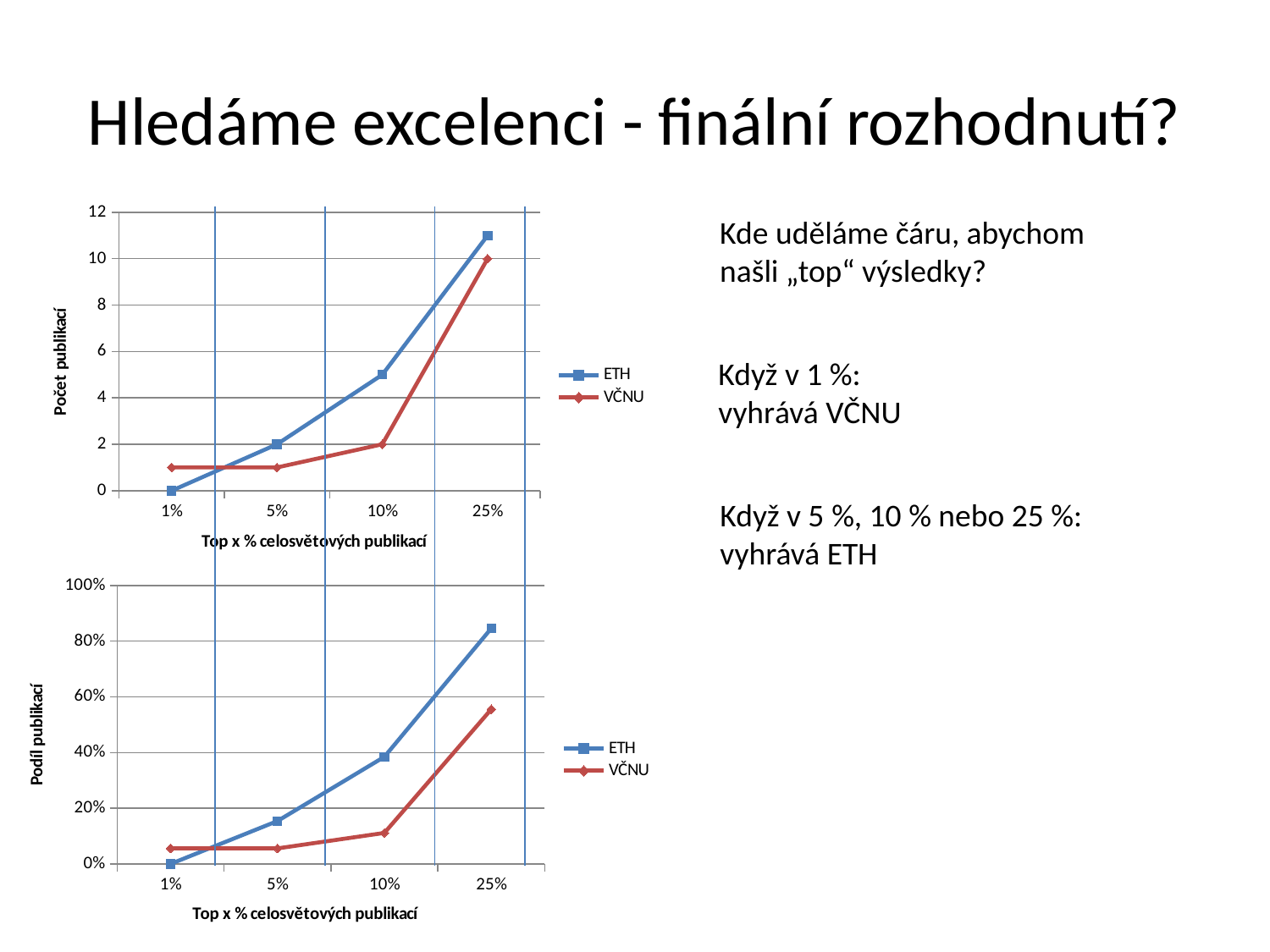
How many series does the legend of the top chart (Počet publikací) list? 2 What is the x-axis title of the bottom chart (Podíl publikací)? Top x % celosvětových publikací In the bottom chart (Podíl publikací), is the value for ETH at 25% greater or less than 80%? greater In the top chart (Počet publikací), what is the value for ETH at 1%? 0 How many categories are on the x axis of the bottom chart (Podíl publikací)? 4 In the top chart (Počet publikací), what is the value for VČNU at 25%? 10 In the top chart (Počet publikací), is the value for ETH at 10% greater or less than 4? greater In the top chart (Počet publikací), what is the value for ETH at 5%? 2 In the top chart (Počet publikací), at which category does ETH reach its highest value? 25% In the bottom chart (Podíl publikací), which series has the higher value at 10%, ETH or VČNU? ETH What kind of chart is the top chart (Počet publikací)? line chart In the bottom chart (Podíl publikací), do the ETH values rise or fall from 1% to 25%? rise